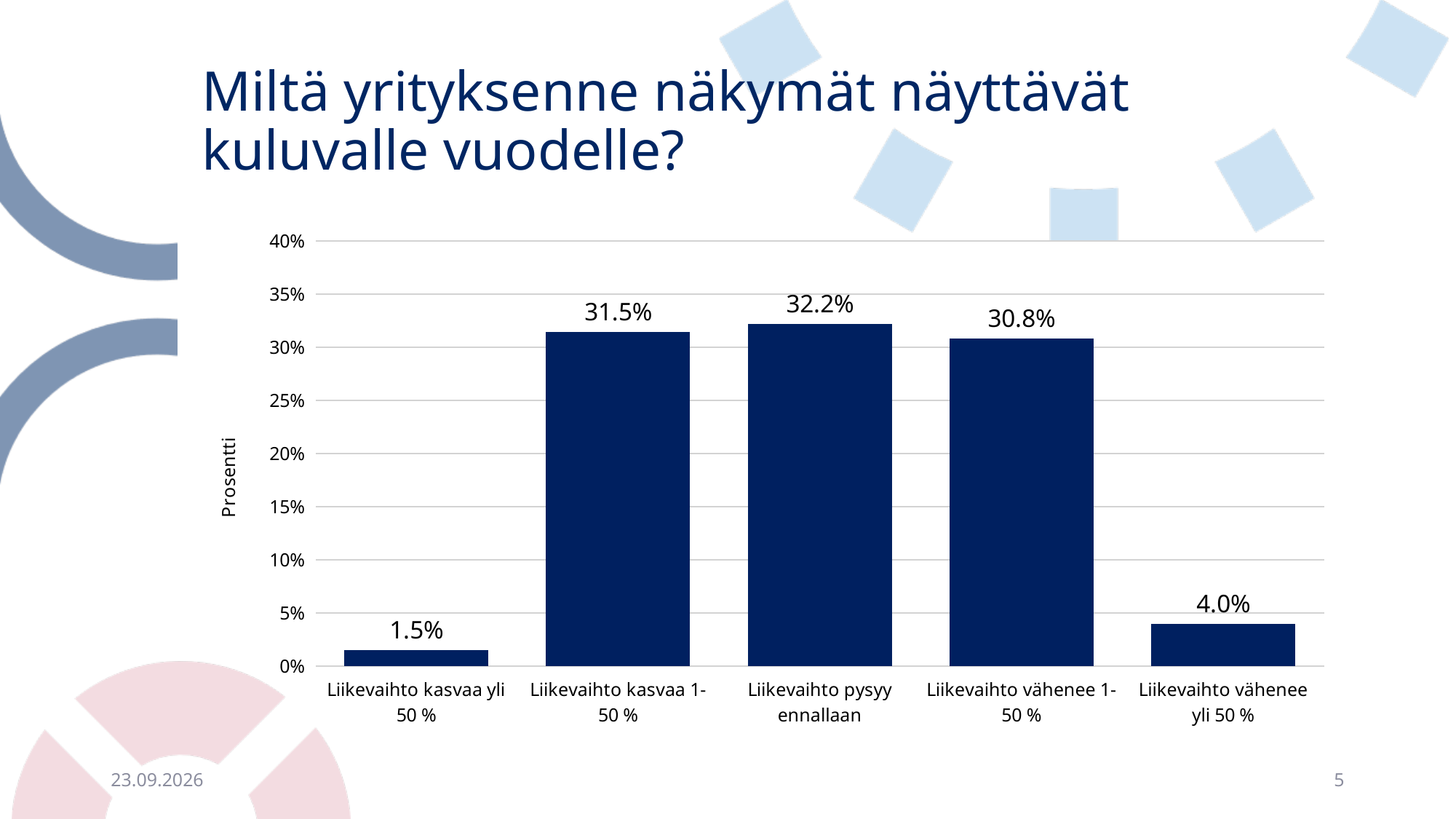
What is the value for "Liikevaihto kasvaa yli 50 %"? 1.5% What is the value for "Liikevaihto kasvaa 1-50 %"? 31.5% What is the value for "Liikevaihto pysyy ennallaan"? 32.2% What is the label of the vertical axis of the chart? Prosentti What is the value for "Liikevaihto vähenee yli 50 %"? 4.0% What is the value for "Liikevaihto vähenee 1-50 %"? 30.8% Is the value for "Liikevaihto kasvaa 1-50 %" greater or less than 30%? greater Which category has the highest value? Liikevaihto pysyy ennallaan How many categories are shown on the x axis of the chart? 5 What kind of chart is shown on the slide? bar chart Which category has the lowest value? Liikevaihto kasvaa yli 50 % What is the difference between the values for "Liikevaihto vähenee yli 50 %" and "Liikevaihto kasvaa yli 50 %"? 2.5 percentage points